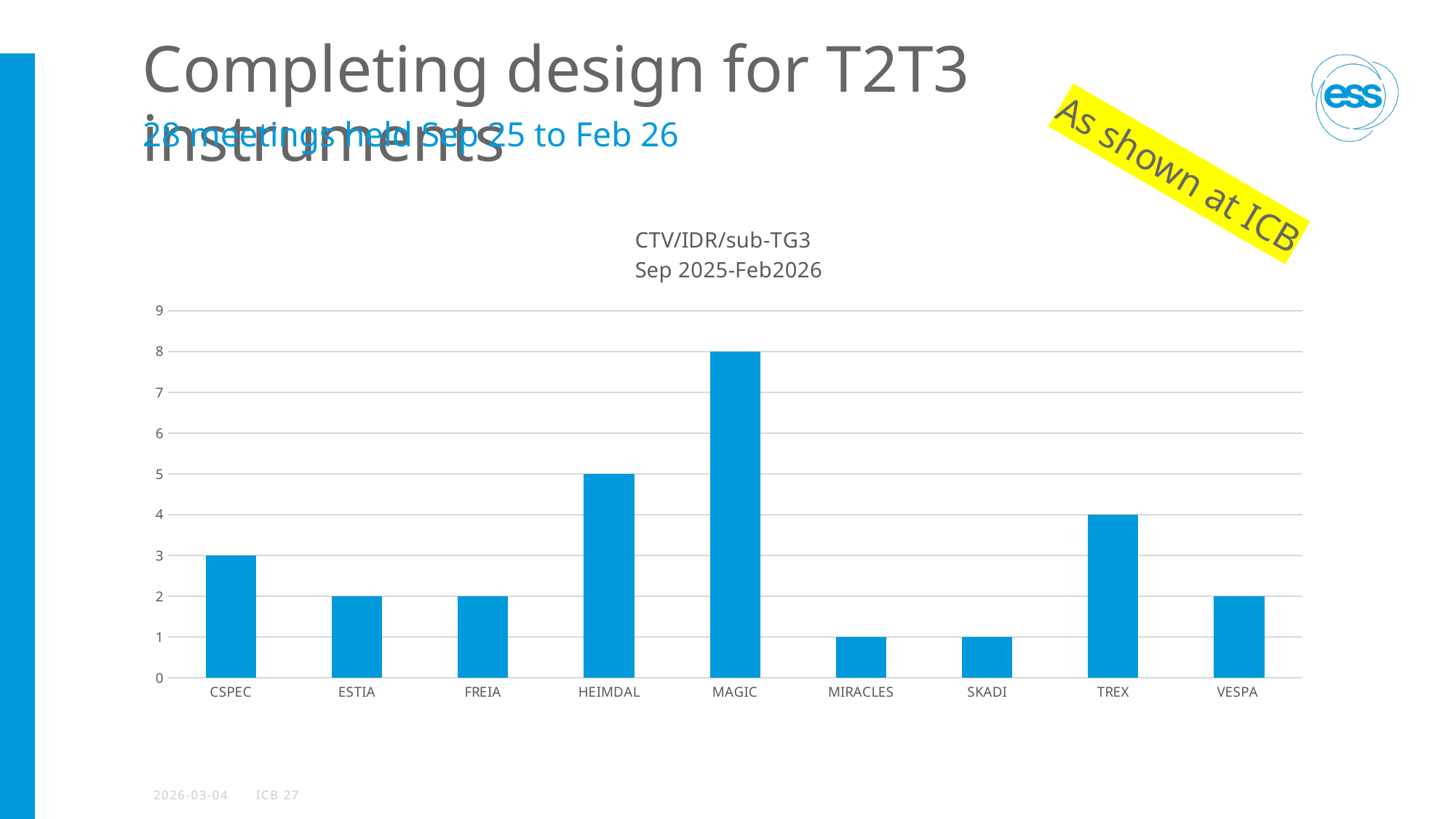
What is the value for HEIMDAL? 5 Which is larger, the value for TREX or the value for CSPEC? TREX Is the value for HEIMDAL greater or less than 4? greater What is the value for CSPEC? 3 What kind of chart is shown on the slide? Bar chart What is the value for TREX? 4 Which instruments have the lowest value? MIRACLES and SKADI How many instruments are shown on the x axis? 9 What is the title of the chart? CTV/IDR/sub-TG3 Sep 2025-Feb2026 Which instrument has the highest bar? MAGIC What is the difference between the values for MAGIC and HEIMDAL? 3 What is the value for MAGIC in the CTV/IDR/sub-TG3 chart? 8